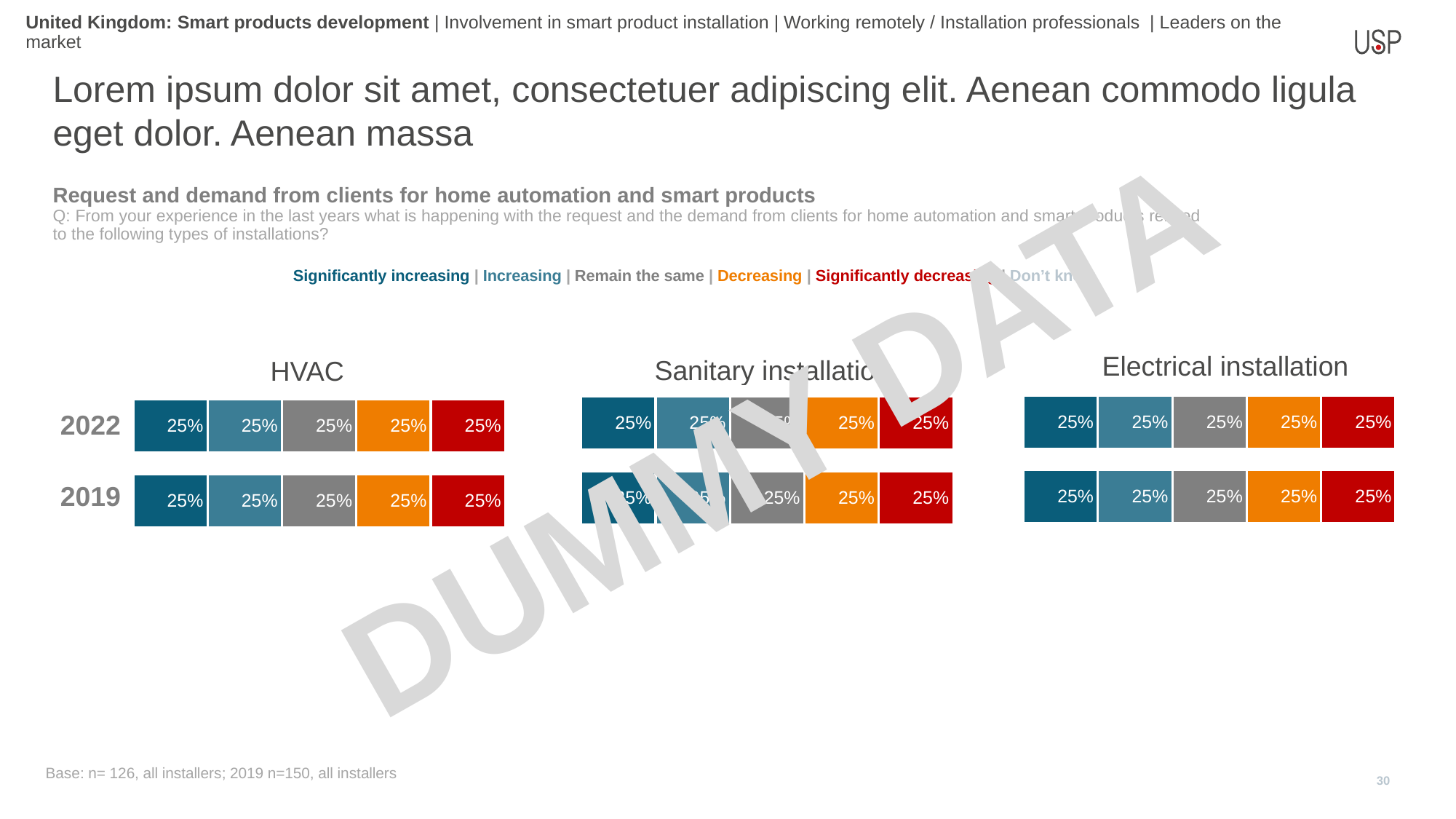
In the Sanitary installation chart, what is the value of the Significantly decreasing segment for 2019? 25% How many segments make up each bar in the Electrical installation chart? 5 What is the title of the chart on the right of the slide? Electrical installation What kind of chart is used for the Sanitary installation data? Stacked bar chart In the Electrical installation chart, what is the value of the Increasing segment for 2022? 25% In the HVAC chart, what is the value of the Remain the same segment for 2019? 25% Which legend entry is shown in orange? Decreasing How many years (rows) are shown in the HVAC chart? 2 In the HVAC chart, what is the value of the Significantly increasing segment for 2022? 25% How many charts are shown on the slide? 3 In the HVAC chart, what is the difference between the Significantly increasing values for 2022 and 2019? 0% In the Electrical installation chart, what is the value of the Decreasing segment for 2019? 25%